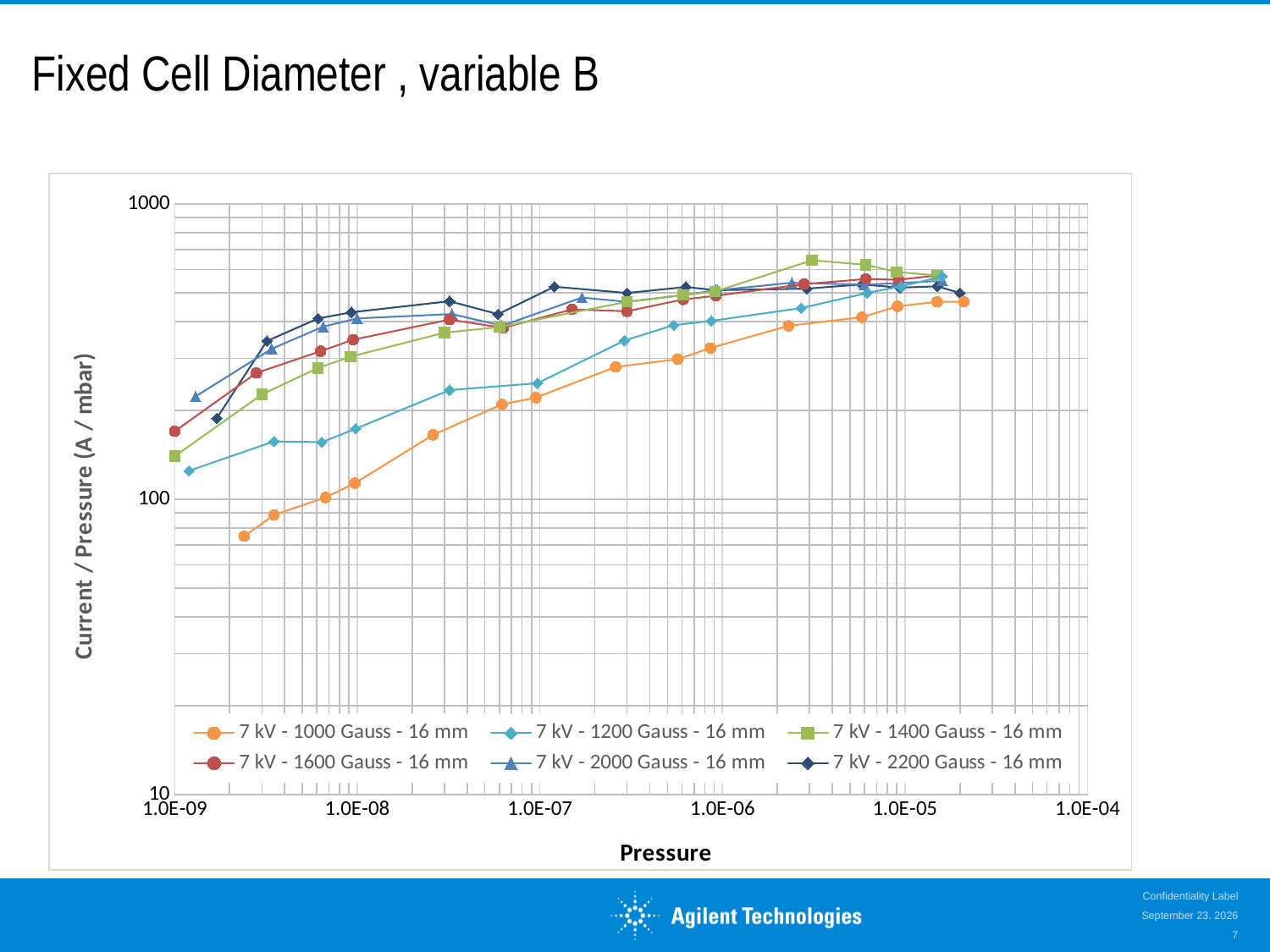
At a pressure of 1.0E-08, which series has the larger value: 7 kV - 2000 Gauss - 16 mm or 7 kV - 1000 Gauss - 16 mm? 7 kV - 2000 Gauss - 16 mm Is the value of the 7 kV - 2200 Gauss - 16 mm series at 1.0E-08 greater or less than 100? greater Which series reaches the highest value anywhere on the chart? 7 kV - 1400 Gauss - 16 mm What kind of chart is shown on the slide? Line chart What is the title of the y axis? Current / Pressure (A / mbar) Which series has the lowest values at the low-pressure end of the chart? 7 kV - 1000 Gauss - 16 mm How many series does the legend list? 6 Is the value of the 7 kV - 1000 Gauss - 16 mm series at 1.0E-05 greater or less than 100? greater What is the title of the x axis? Pressure Which series is drawn with orange circle markers? 7 kV - 1000 Gauss - 16 mm Does the value for the 7 kV - 1000 Gauss - 16 mm series rise or fall as pressure increases along the x axis? Rise Is the lowest-pressure value of the 7 kV - 1000 Gauss - 16 mm series greater or less than 100? less